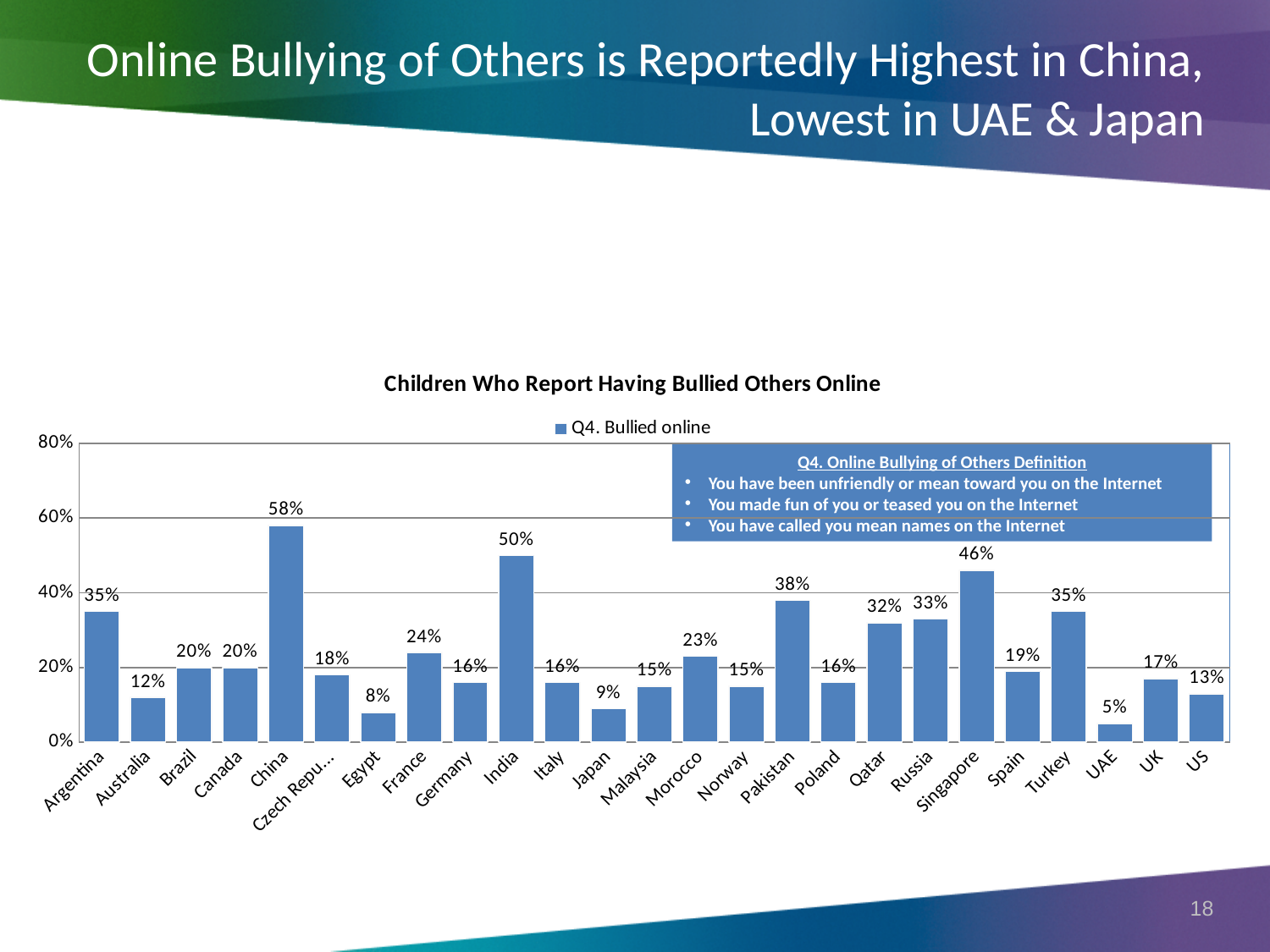
How many countries are shown on the x axis of the chart? 25 What percentage of children in India report having bullied others online? 50% What is the value for China in the chart? 58% What type of chart is shown on the slide? Bar chart Which has a larger value, Qatar or Russia? Russia What is the difference between the values for Singapore and Pakistan? 8% Which has a larger value, Egypt or Japan? Japan What is the title of the chart? Children Who Report Having Bullied Others Online What is the value shown for UAE? 5% What is the difference between the values for China and India? 8% Which country has the lowest value in the chart? UAE Which country has the highest value in the chart? China